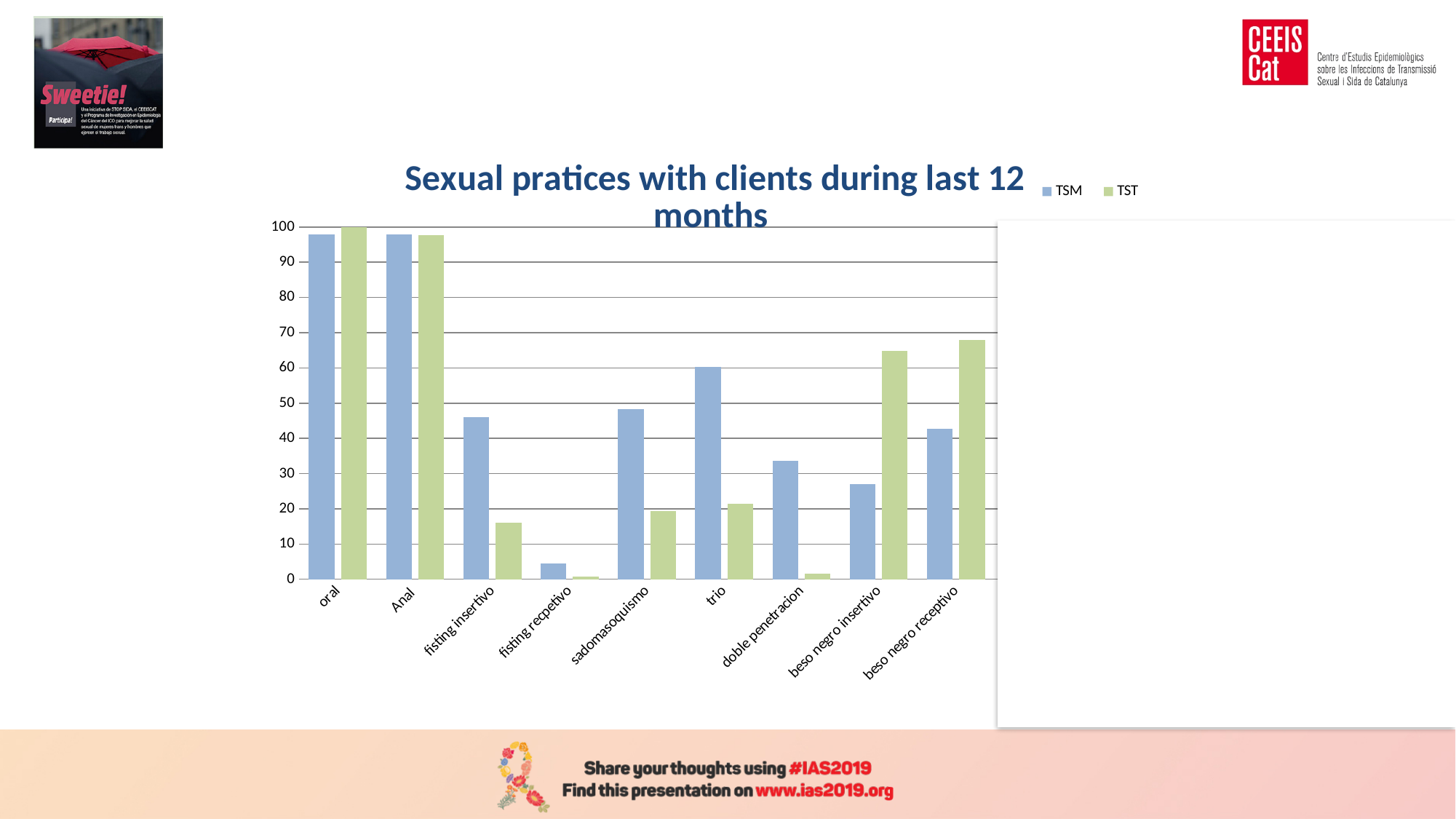
Is the TSM value for trio greater or less than 50? greater What is the title of the chart? Sexual pratices with clients during last 12 months How many categories are shown on the x axis? 9 For beso negro insertivo, which series has the larger value, TSM or TST? TST How many series does the legend list? 2 Is the TST value for beso negro receptivo greater or less than 60? greater For trio, which series has the larger value, TSM or TST? TSM Is the TST value for fisting insertivo greater or less than 20? less What kind of chart is shown on the slide? bar chart For doble penetracion, which series has the larger value, TSM or TST? TSM Which category has the lowest TSM value? fisting recpetivo What colour are the TST bars? green